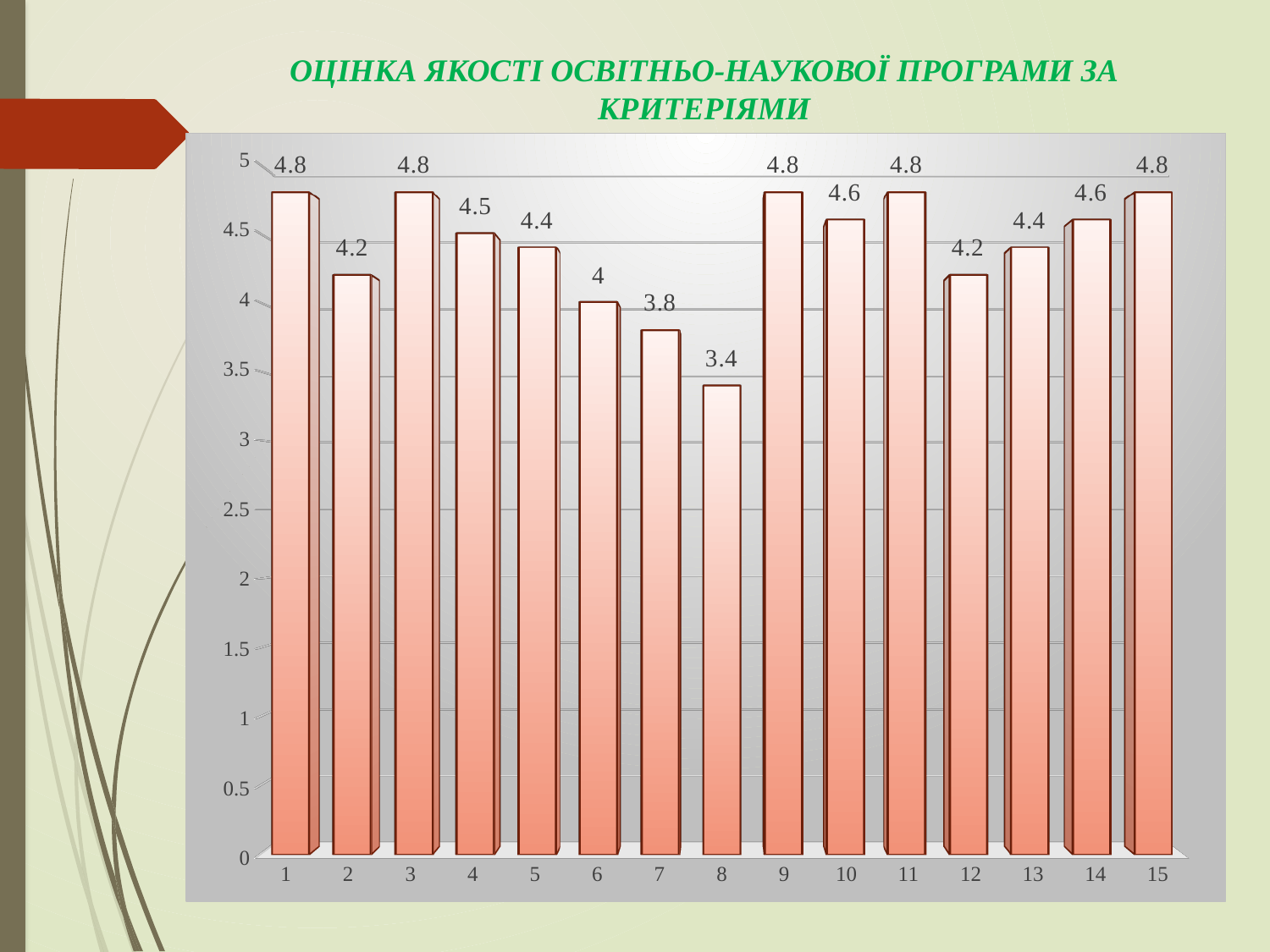
Which criterion has the lowest value? 8 What is the difference between the values for criterion 10 and criterion 12? 0.4 What is the highest value shown on the chart? 4.8 Do the values rise or fall from criterion 3 to criterion 8? fall What kind of chart is shown on the slide? bar chart How many criteria are shown on the x axis? 15 Which has a larger value, criterion 6 or criterion 7? criterion 6 What is the value for criterion 10? 4.6 What is the value for criterion 8? 3.4 What is the difference between the values for criterion 1 and criterion 8? 1.4 Is the value for criterion 8 greater or less than 3.5? less What is the value for criterion 4? 4.5